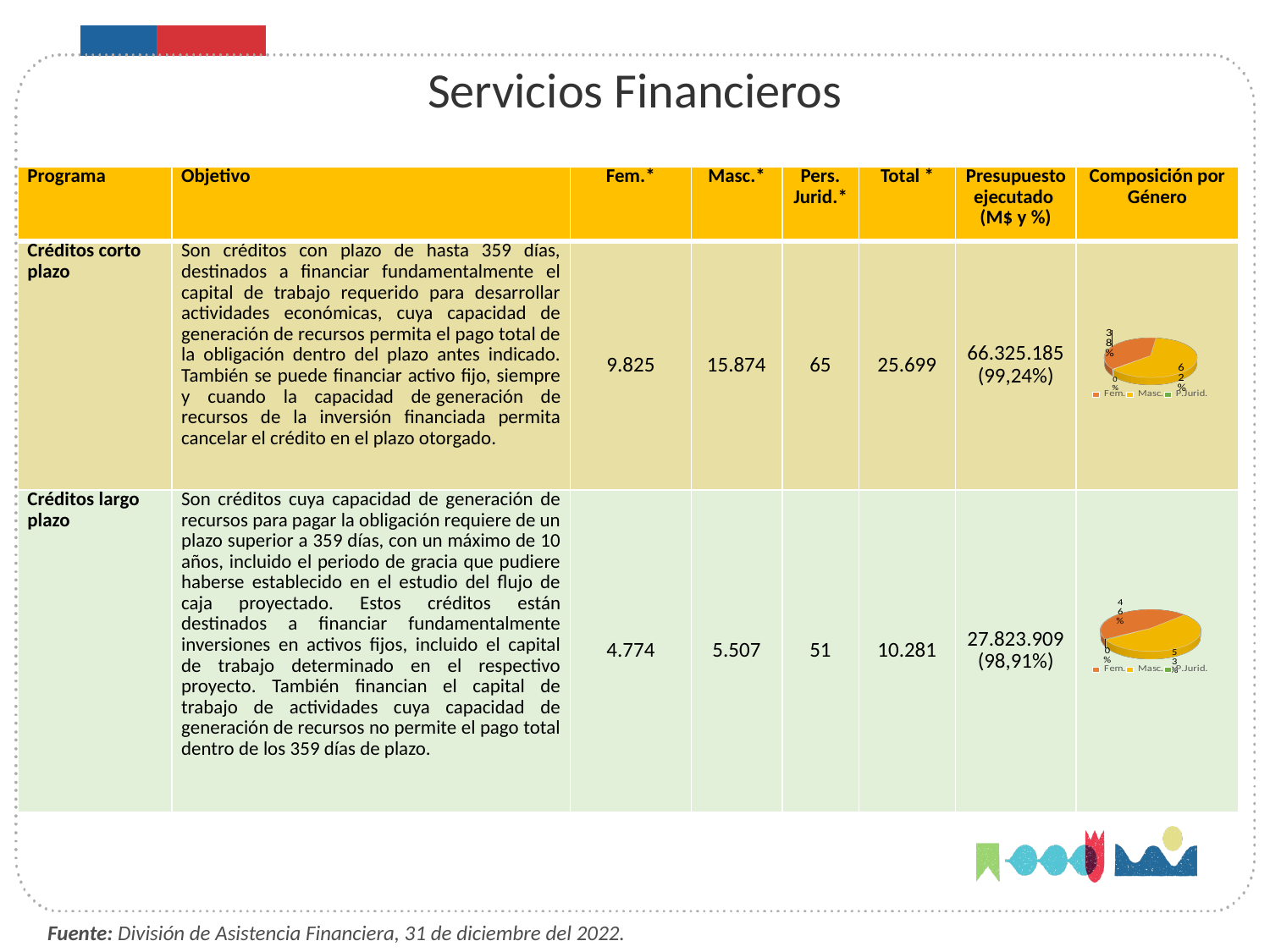
What are the legend entries of the Créditos largo plazo pie chart? Fem., Masc., P.Jurid. In the Créditos corto plazo pie chart, which category has the largest slice? Masc. In the Créditos corto plazo pie chart, what share is labelled for Fem.? 38% In the Créditos corto plazo pie chart, what share is labelled for Masc.? 62% In the Créditos largo plazo pie chart, what share is labelled for Fem.? 46% In the Créditos largo plazo pie chart, which slice is larger, Fem. or Masc.? Masc. In the Créditos corto plazo pie chart, which slice is larger, Fem. or Masc.? Masc. What kind of chart is shown in the 'Composición por Género' column for Créditos corto plazo? pie chart How many pie charts are shown on the slide? 2 How many slices does the Créditos largo plazo pie chart have? 3 How many entries does the legend of the Créditos corto plazo pie chart list? 3 In the Créditos largo plazo pie chart, which category has the smallest slice? P.Jurid.